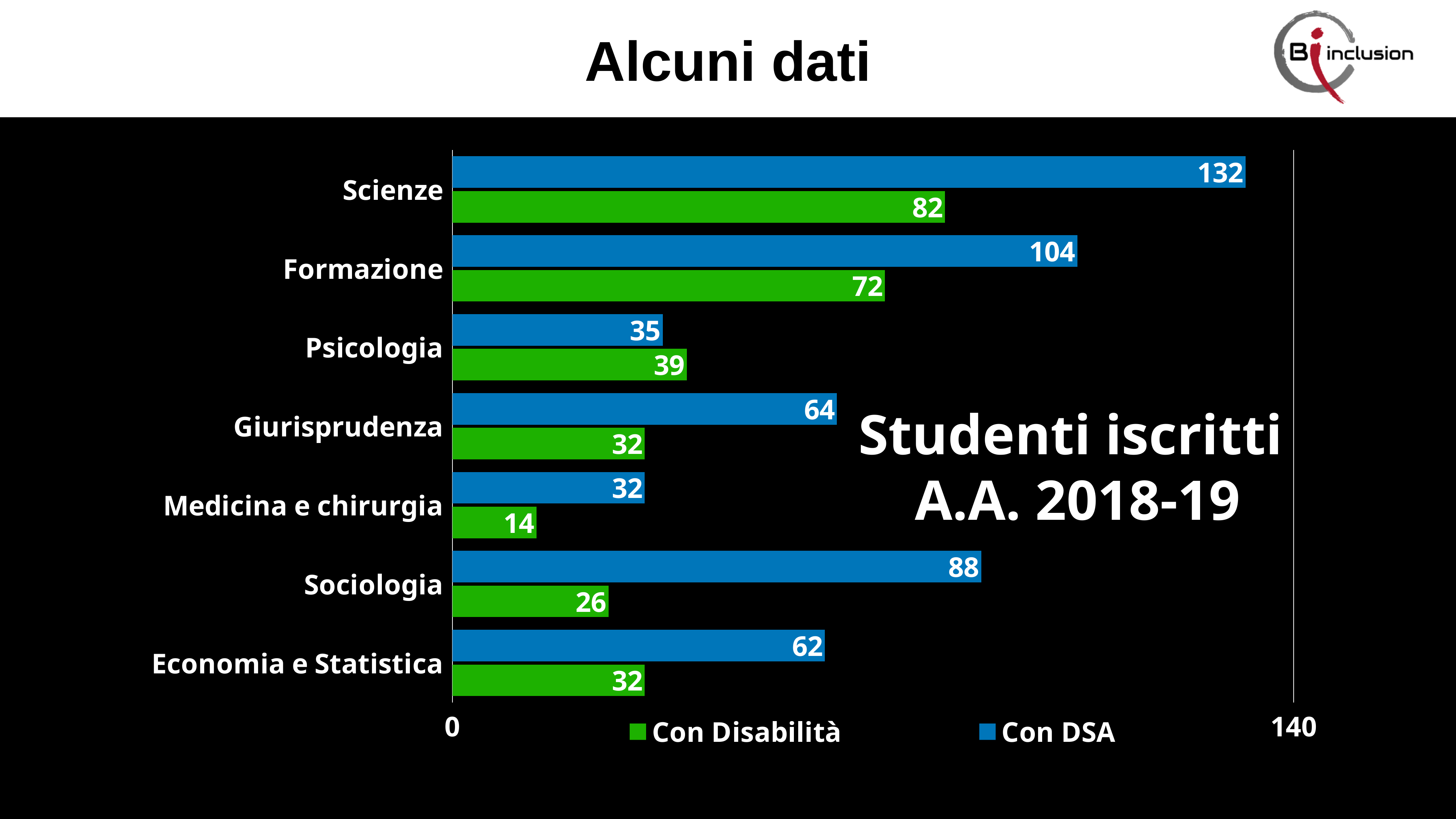
What is the Con Disabilità value for Medicina e chirurgia? 14 Which category has the highest Con DSA value? Scienze What is the Con Disabilità value for Formazione? 72 Which colour represents the Con DSA series? Blue What is the difference between the Con DSA and Con Disabilità values for Sociologia? 62 What is the Con DSA value for Scienze? 132 What kind of chart is shown on the slide? Bar chart What is the difference between the Con DSA values for Scienze and Formazione? 28 Which category has the lowest Con Disabilità value? Medicina e chirurgia How many categories are shown on the chart? 7 Which is larger for Psicologia: Con Disabilità or Con DSA? Con Disabilità How many series does the legend list? 2